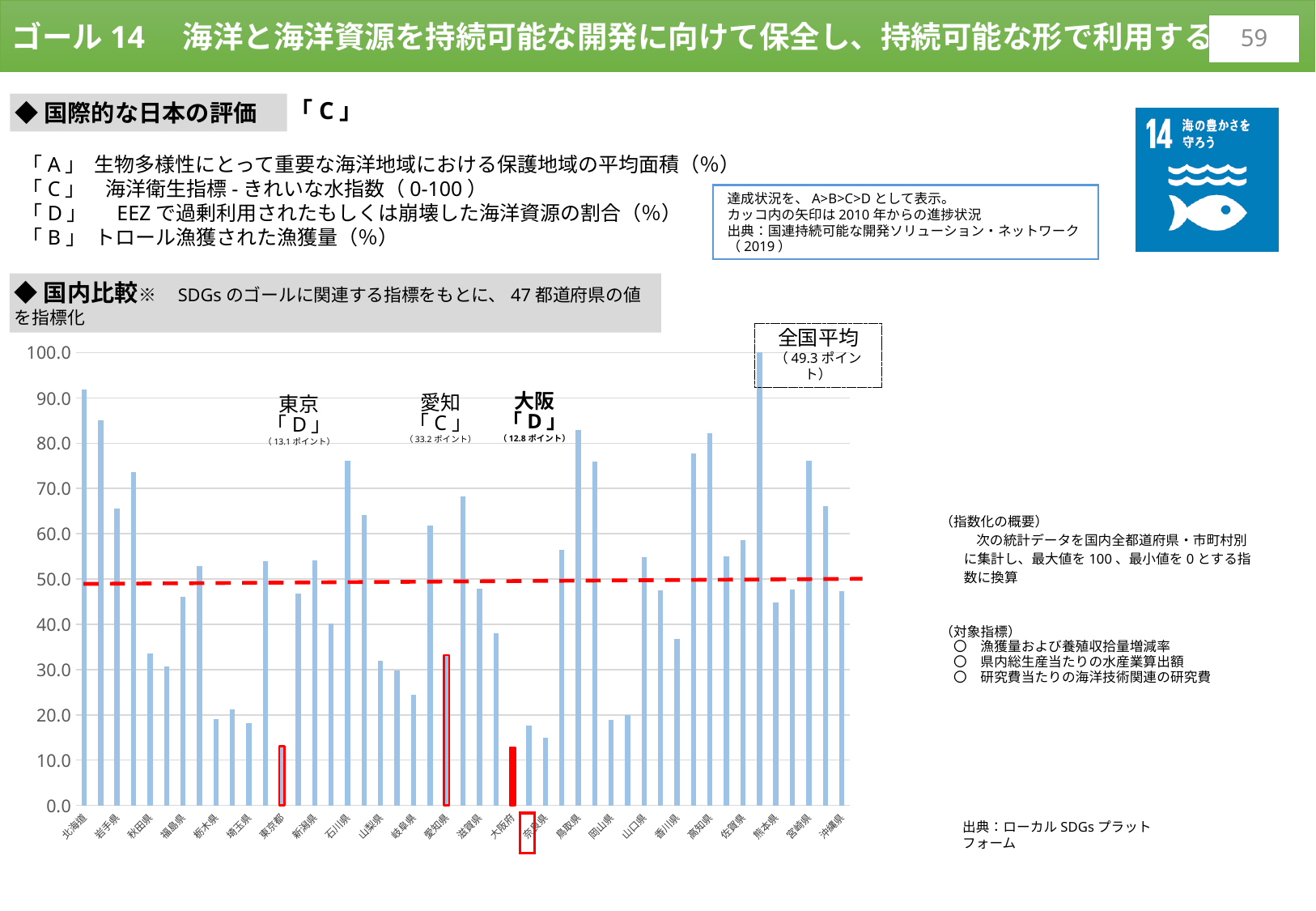
What is the difference between the values for 愛知 and 東京? 20.1 ポイント What is the value shown for 大阪 on the bar chart? 12.8 ポイント What kind of chart is used for the 国内比較 section? bar chart Which has the larger value, 東京 or 大阪? 東京 What is the 全国平均 (national average) value shown on the chart? 49.3 ポイント Is the value for 北海道 greater or less than 80? greater What does the red dashed horizontal line on the chart represent? 全国平均 (49.3 ポイント) What is the value shown for 愛知 on the bar chart? 33.2 ポイント What is the value shown for 東京 on the bar chart? 13.1 ポイント Which of the three labelled prefectures (東京, 愛知, 大阪) has the lowest value? 大阪 Is the value for 奈良県 greater or less than 20? less Is the value for 石川県 greater or less than 70? greater